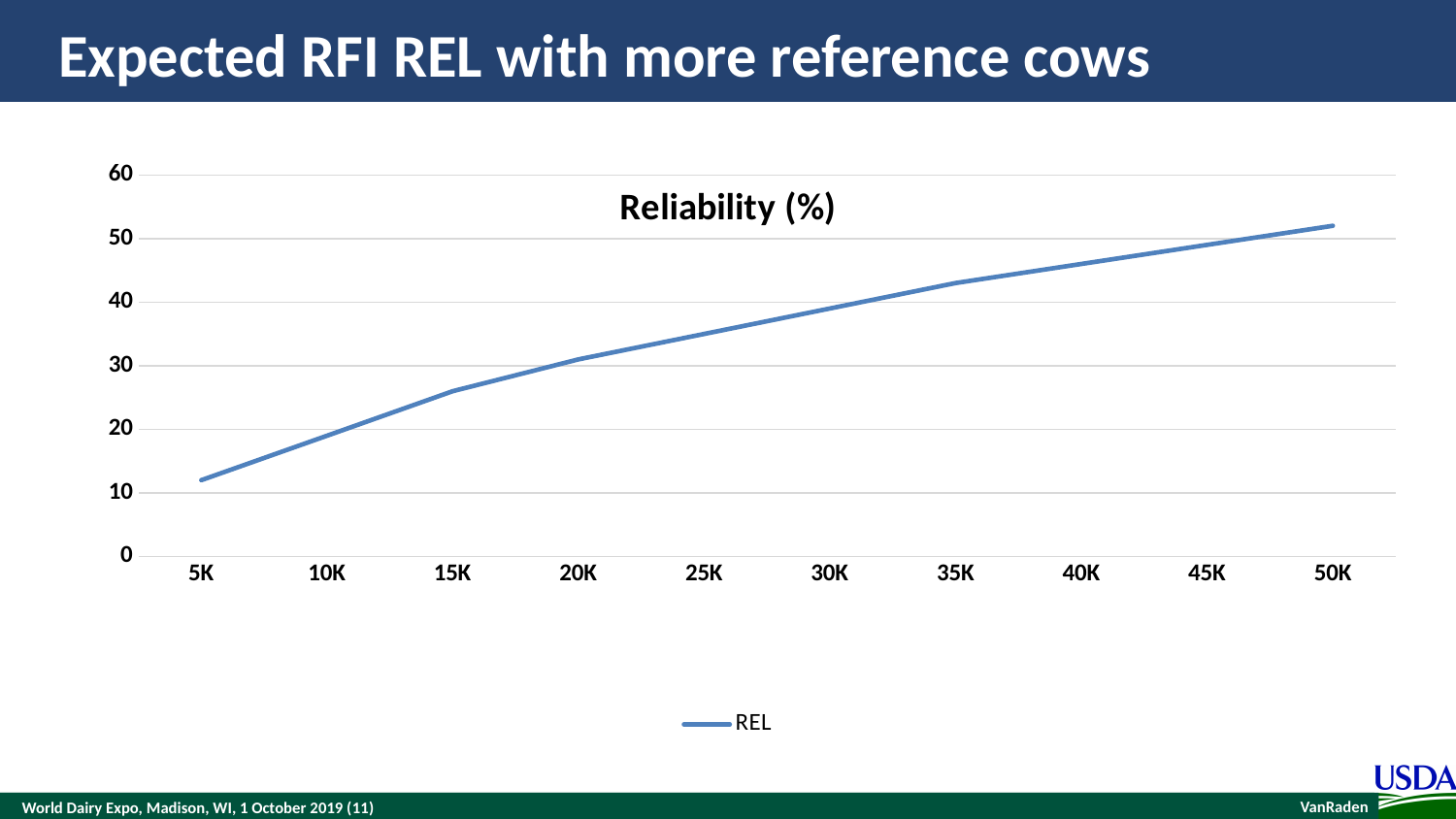
Which category has the lowest REL value? 5K What is the title shown inside the chart area? Reliability (%) Which category has the highest REL value? 50K Is the REL value for 40K greater or less than 50? less How many series does the legend list? 1 What kind of chart is shown on the slide? line chart Does the REL value rise or fall as the number of reference cows increases from 5K to 50K? rise Is the REL value for 15K greater or less than 30? less Is the REL value for 5K greater or less than 10? greater How many categories are shown on the x axis? 10 What is the name of the series in the legend? REL